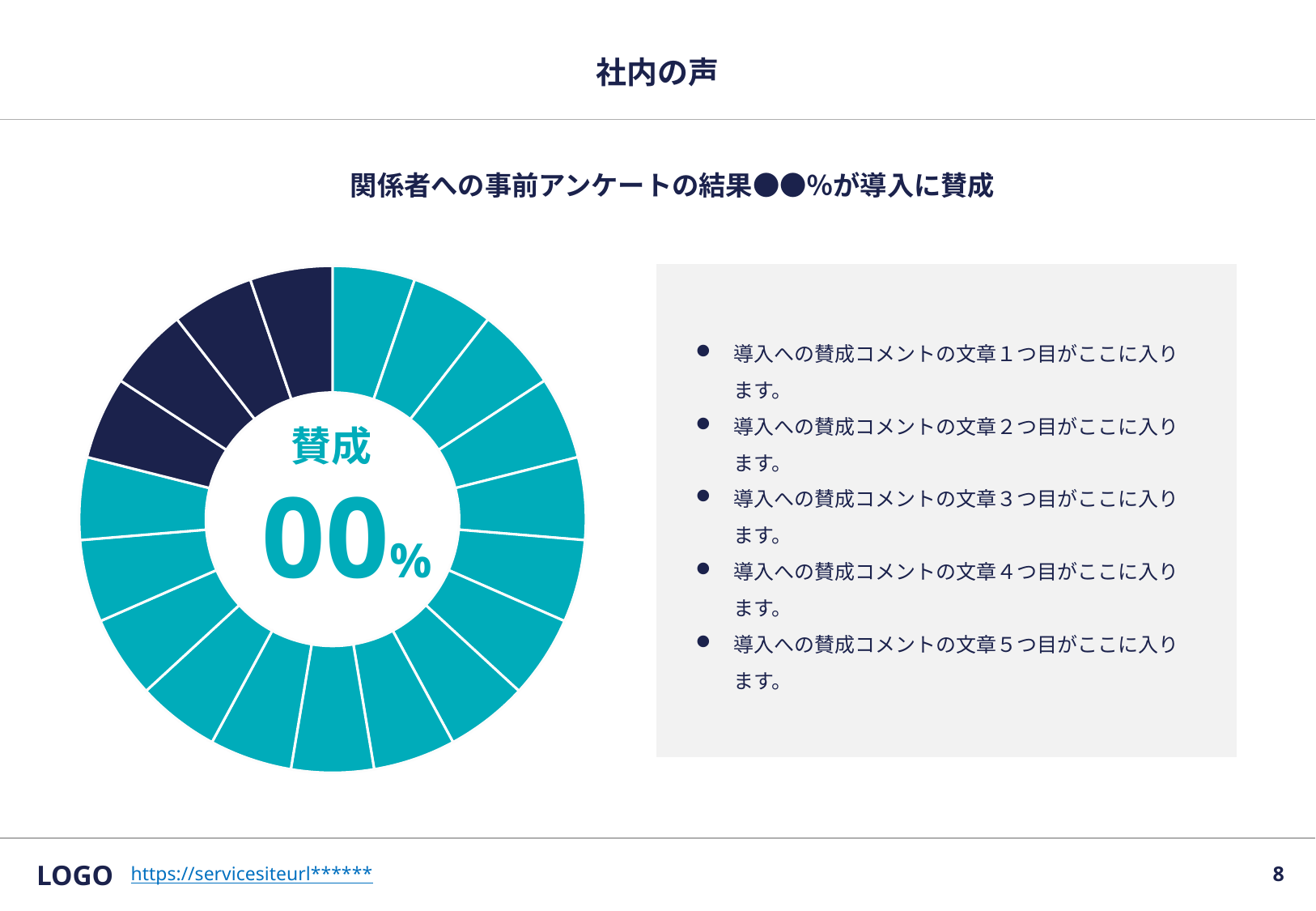
How many different colours are used for the segments of the donut chart? 2 Which colour occupies the larger share of the donut chart, teal or dark navy? Teal Is the dark navy portion of the donut chart greater or less than half of the chart? less What percentage value is printed in the centre of the donut chart? 00% What kind of chart is shown on the left of the slide? Pie chart (donut) Is the teal portion of the donut chart greater or less than half of the chart? greater Which colour occupies the smaller share of the donut chart? Dark navy What label is printed in the centre of the donut chart? 賛成